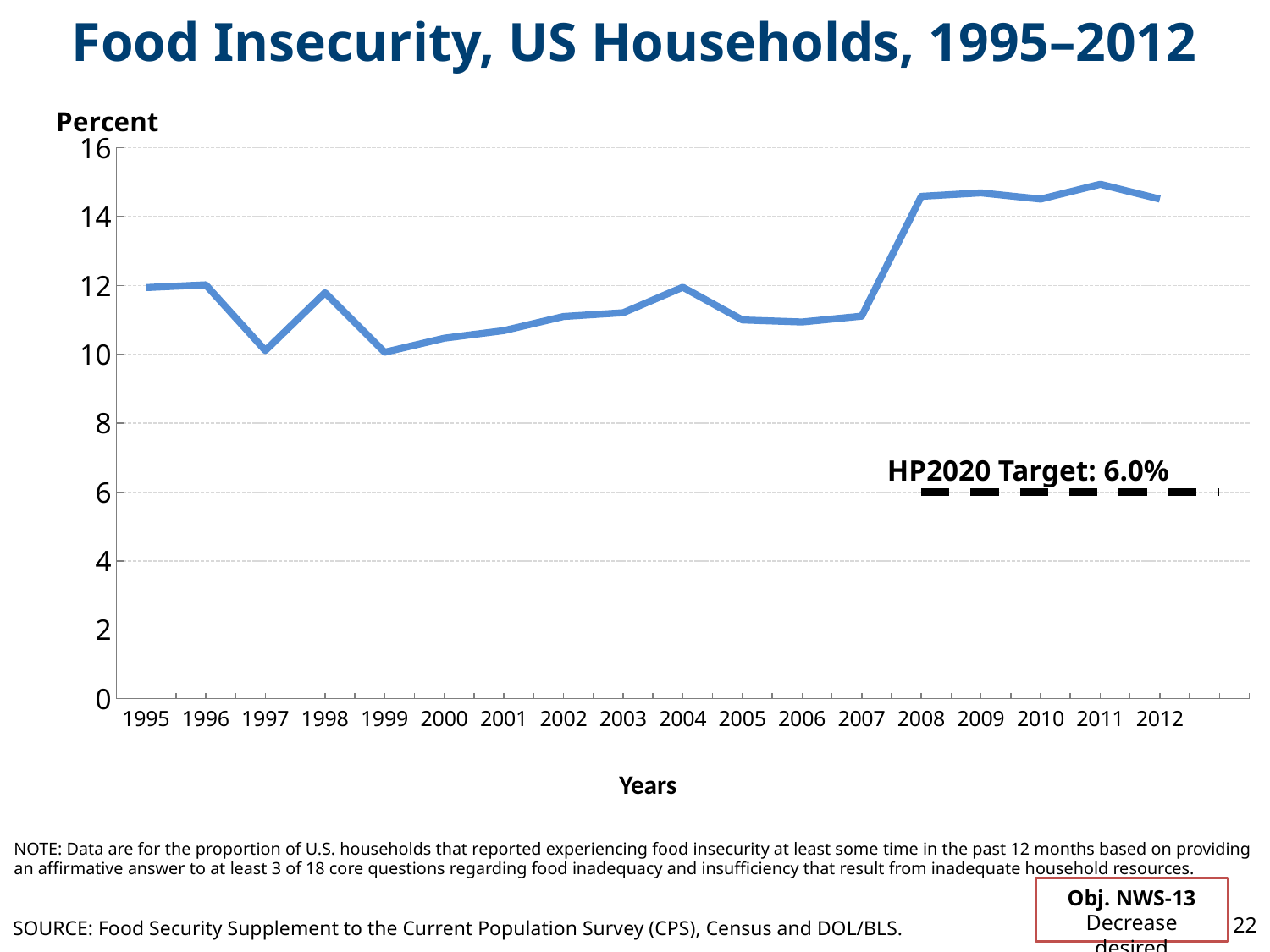
Which year has the larger value, 2007 or 2008? 2008 Is the value for 2005 greater or less than 12? less What kind of chart is shown on the slide? line chart Which year has the larger value, 1997 or 1998? 1998 What is the label on the x axis? Years Is the value for 2008 greater or less than 14? greater Is the value for 2002 greater or less than 10? greater What is the title of the chart? Food Insecurity, US Households, 1995–2012 How many years are plotted along the x axis? 18 Does the food insecurity percentage rise or fall between 2007 and 2008? rise What is the HP2020 Target value shown on the chart? 6.0%